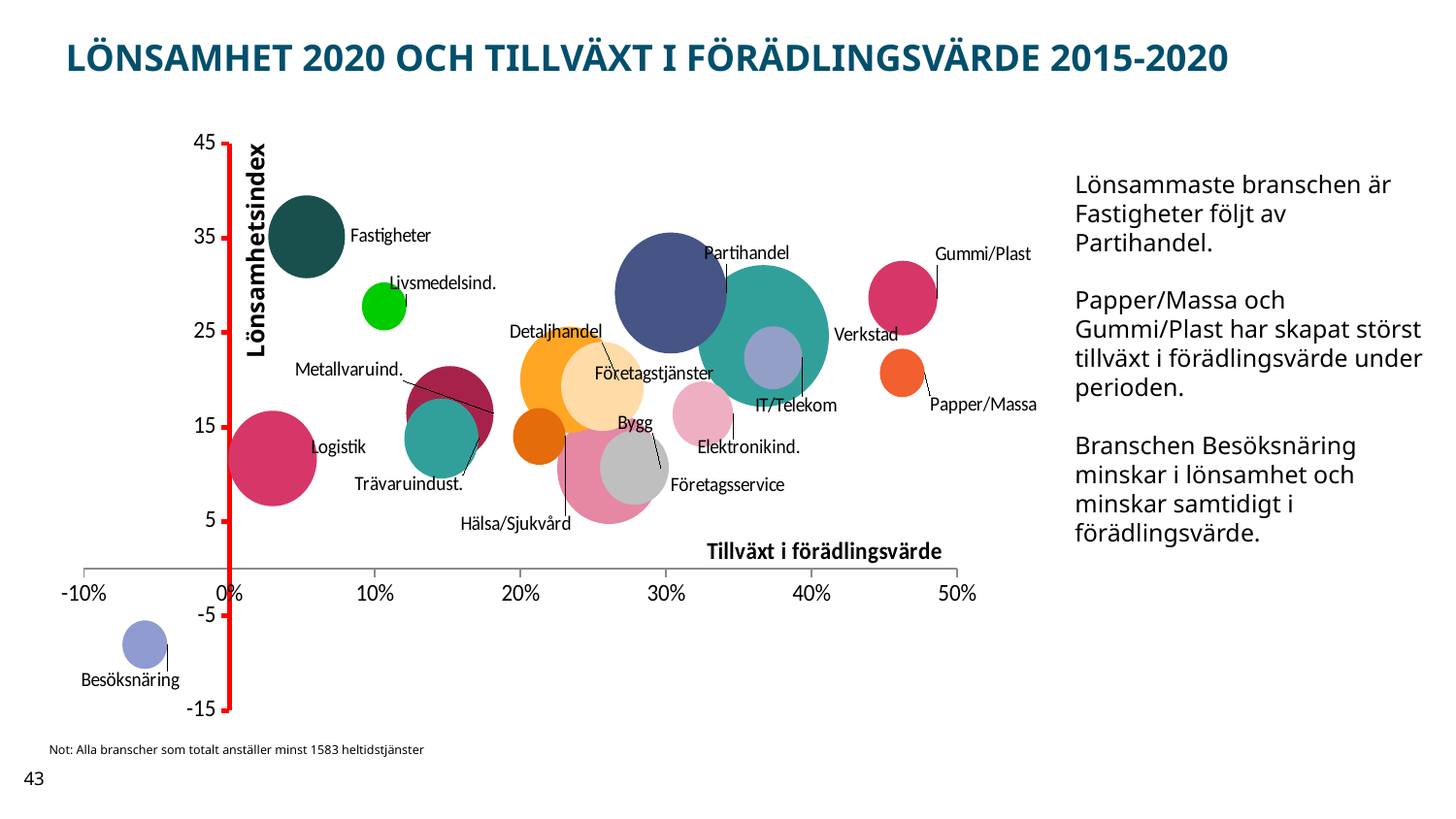
What is the label of the horizontal axis of the chart? Tillväxt i förädlingsvärde Is the Tillväxt i förädlingsvärde for Logistik greater or less than 10%? less Which has a higher Lönsamhetsindex, Fastigheter or Logistik? Fastigheter Which has a higher Tillväxt i förädlingsvärde, Gummi/Plast or Logistik? Gummi/Plast What kind of chart is shown on the slide? Bubble chart Is the Lönsamhetsindex for Fastigheter greater or less than 25? greater Which industry has the lowest Lönsamhetsindex in the chart? Besöksnäring What is the label of the vertical axis of the chart? Lönsamhetsindex Is the Tillväxt i förädlingsvärde for Besöksnäring greater or less than 0%? less Which industry has the highest Lönsamhetsindex in the chart? Fastigheter Which industry has the lowest Tillväxt i förädlingsvärde in the chart? Besöksnäring